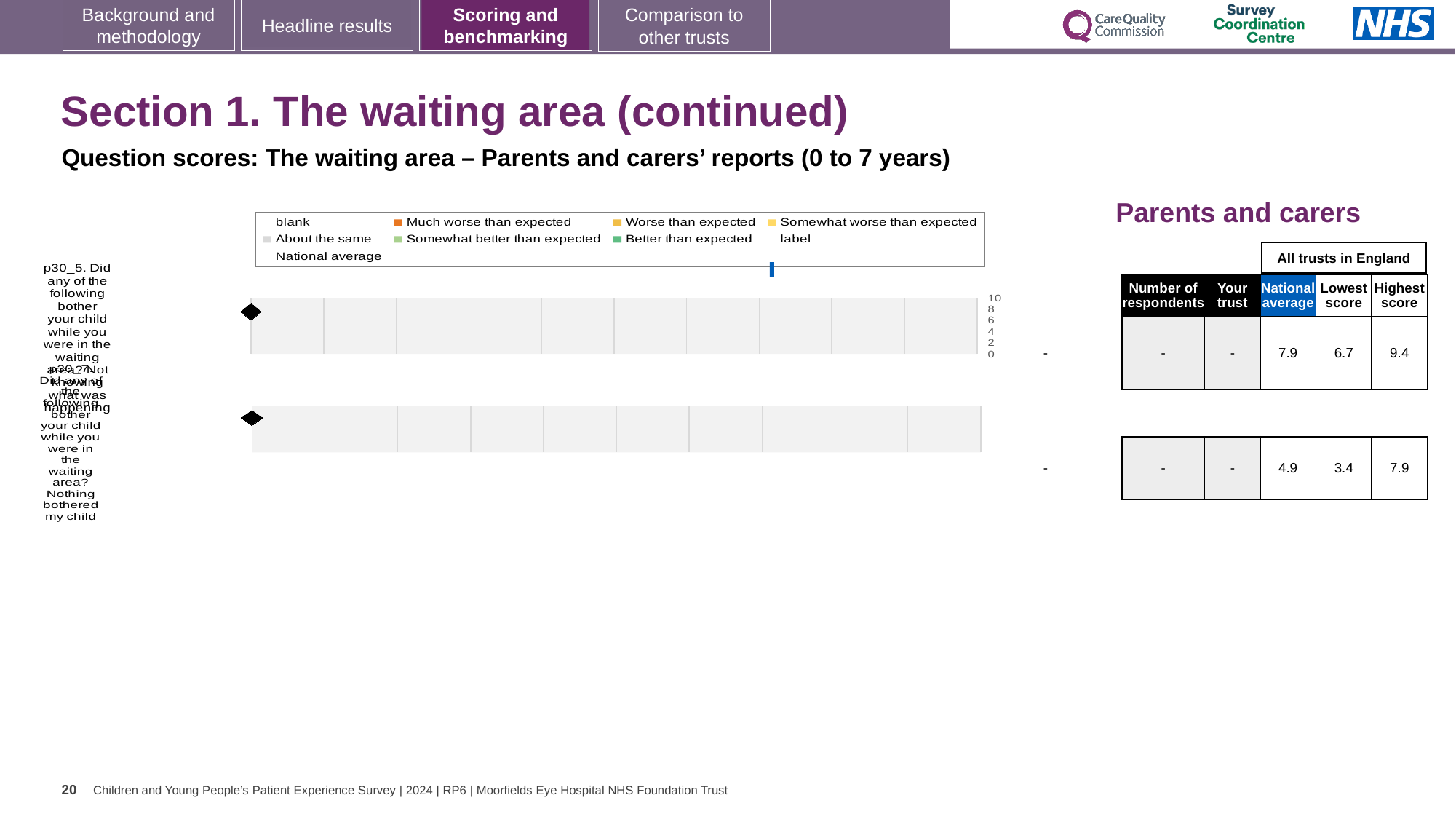
What is the highest value shown on the chart's numeric axis? 10 How many charts are shown on the slide? 2 What is the difference between the highest and lowest scores across all trusts for the 'Nothing bothered my child' question? 4.5 In the table, what is the highest score across all trusts in England for the 'Nothing bothered my child' question? 7.9 In the table, what is the lowest score across all trusts in England for the 'Not knowing what was happening' question? 6.7 In the table, what is the 'Your trust' score shown for the 'Not knowing what was happening' question? - Which question has the higher national average in the table: 'Not knowing what was happening' or 'Nothing bothered my child'? Not knowing what was happening In the table, what is the national average for the question about not knowing what was happening in the waiting area? 7.9 In the table, what is the national average for the question about nothing bothering my child in the waiting area? 4.9 What kind of chart is used on this slide for the question scores? bar chart What colour is the legend marker for 'Much worse than expected'? orange